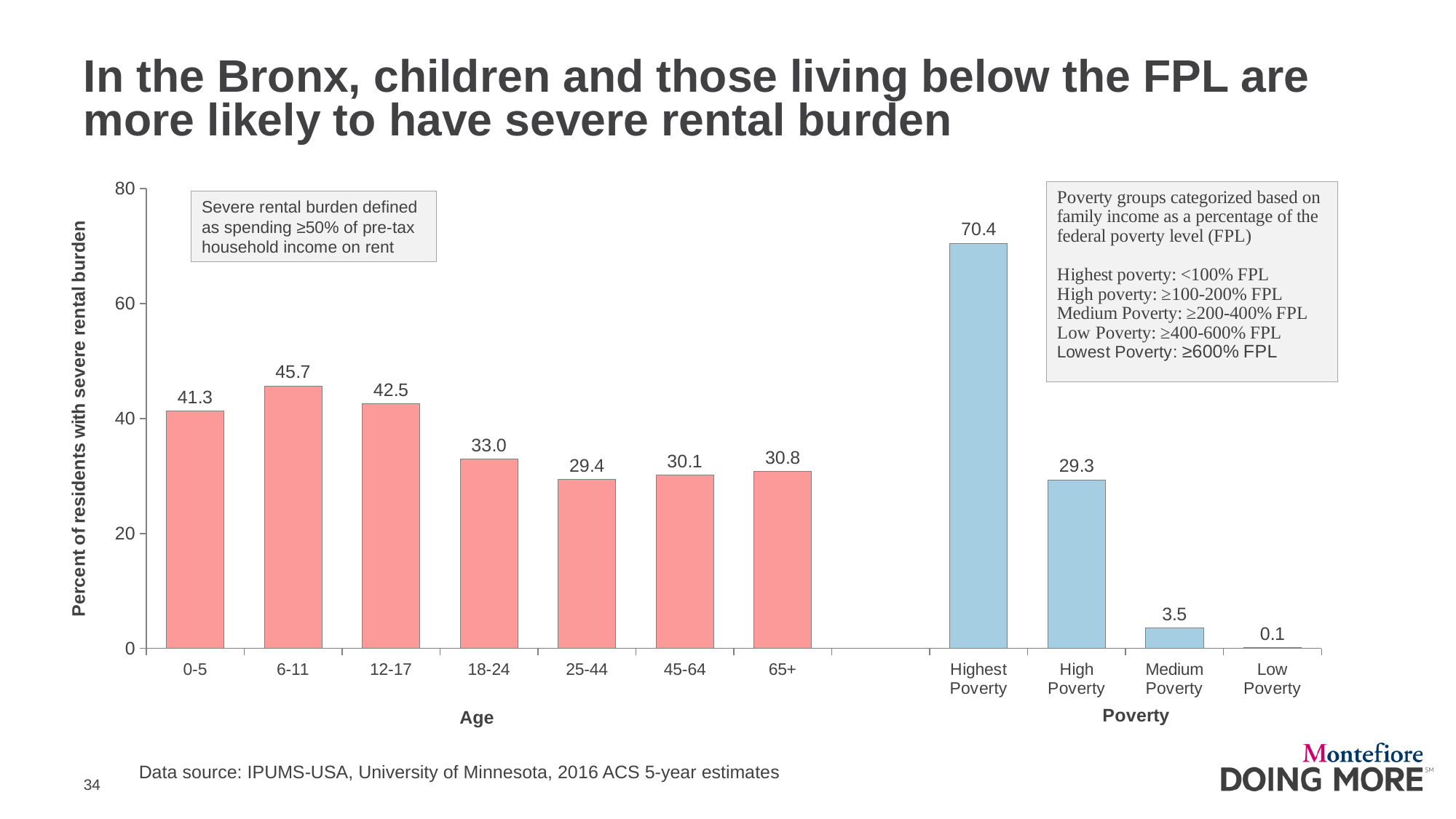
What is the percent of residents with severe rental burden for the 6-11 age group? 45.7 Which poverty group has the lowest percent of residents with severe rental burden? Low Poverty What kind of chart is shown on the slide? Bar chart What is the difference between the values for the 0-5 and 18-24 age groups? 8.3 What is the value shown for the Medium Poverty group? 3.5 Which age group has the highest percent of residents with severe rental burden? 6-11 What is the difference between the values for the Highest Poverty and High Poverty groups? 41.1 Which age group has the lowest percent of residents with severe rental burden? 25-44 What is the label of the vertical axis? Percent of residents with severe rental burden How many age groups are shown on the chart? 7 Which has a higher value, the 12-17 age group or the 65+ age group? 12-17 What is the percent of residents with severe rental burden for the Highest Poverty group? 70.4